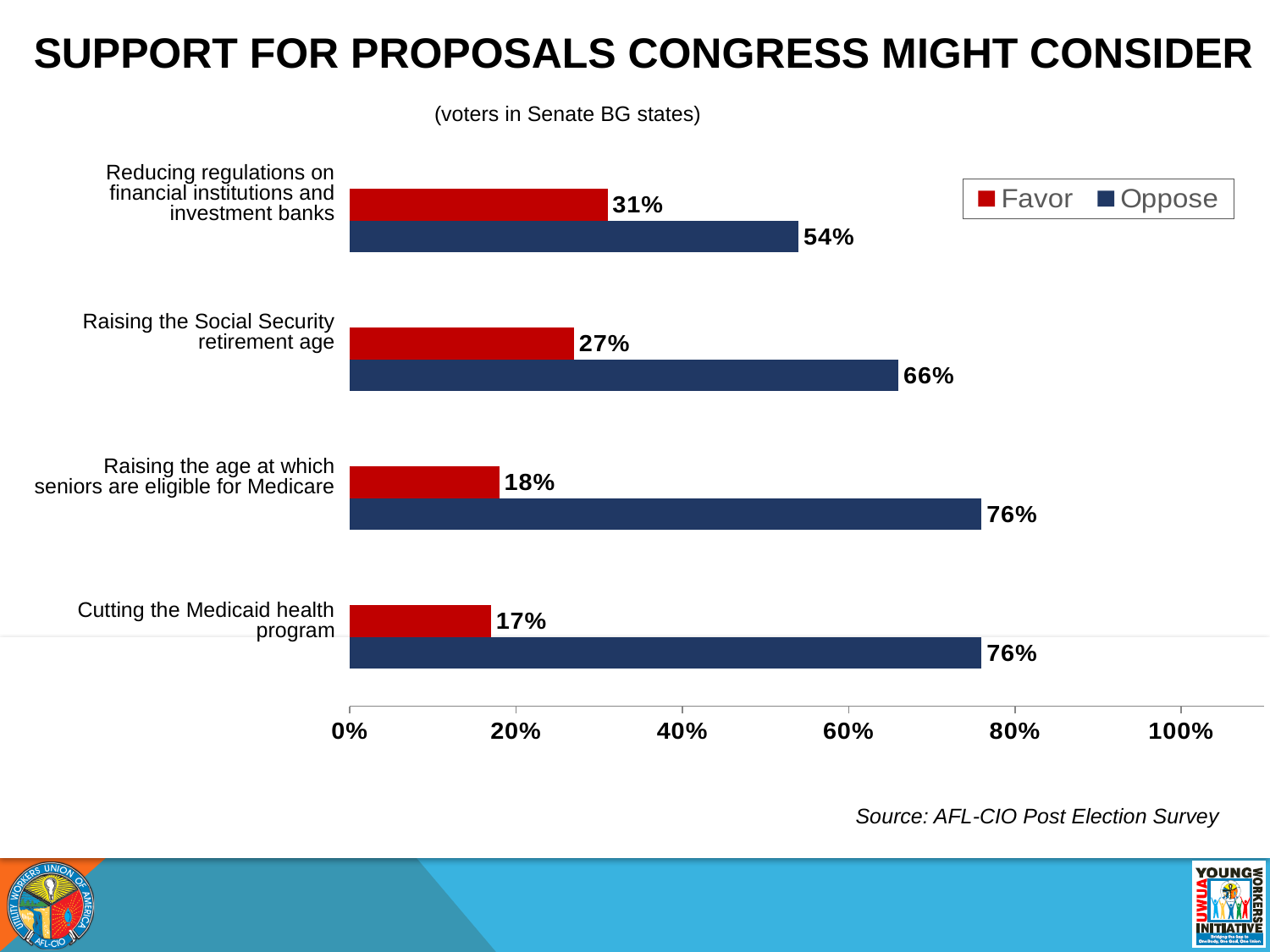
What is the difference between the Oppose and Favor percentages for raising the age at which seniors are eligible for Medicare? 58% What percentage of voters favor cutting the Medicaid health program? 17% What type of chart is shown on the slide? Bar chart How many series does the legend list? 2 What percentage of voters oppose raising the Social Security retirement age? 66% What percentage of voters favor reducing regulations on financial institutions and investment banks? 31% How many proposals are shown in the chart? 4 Which colour represents the Oppose series in the chart? Dark blue Which proposal has the lowest Favor percentage? Cutting the Medicaid health program Which proposal has the lowest Oppose percentage? Reducing regulations on financial institutions and investment banks Which proposal has the highest Favor percentage? Reducing regulations on financial institutions and investment banks Is the Oppose percentage for raising the Social Security retirement age larger or smaller than the Oppose percentage for reducing regulations on financial institutions? Larger